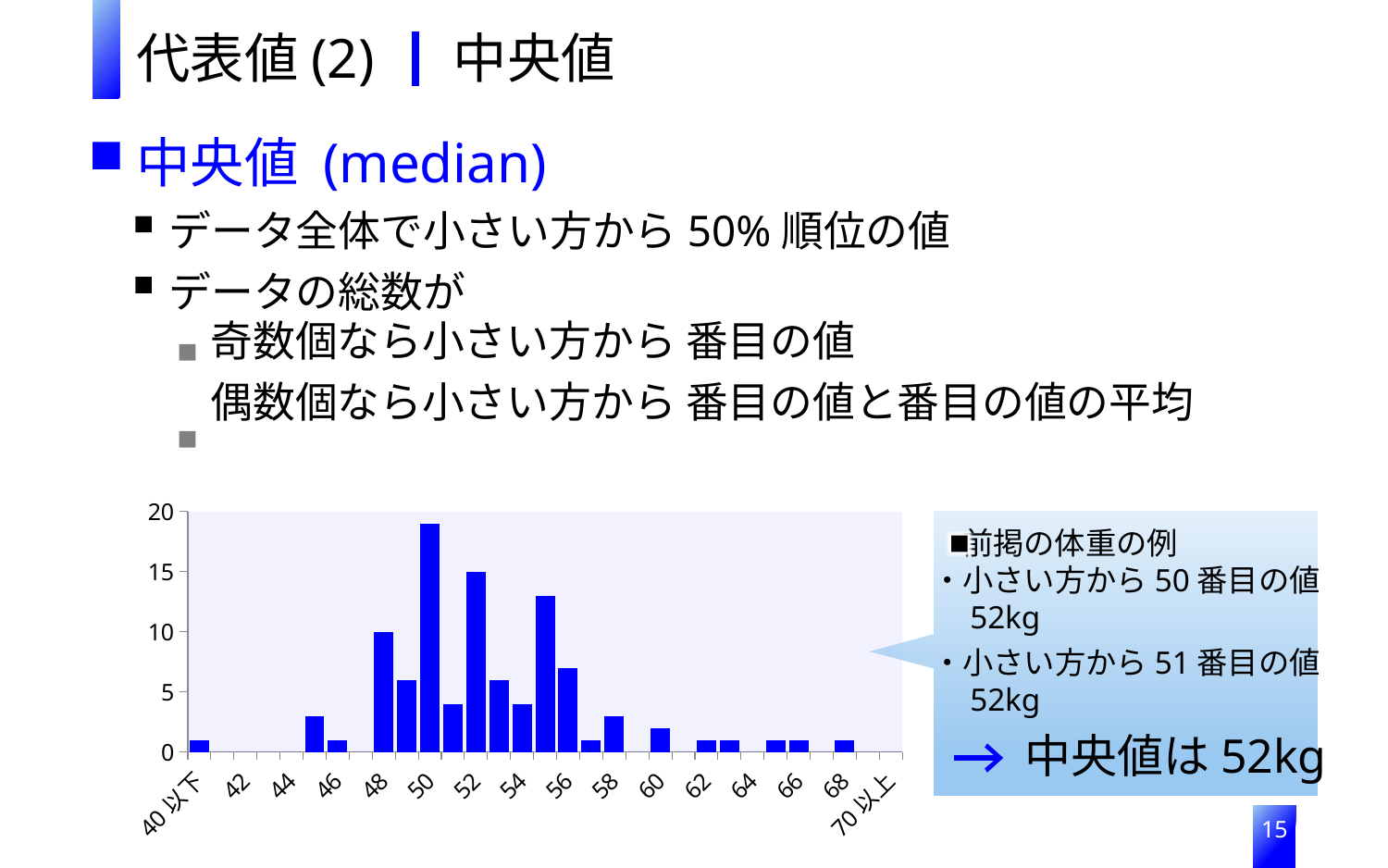
Which x-axis category has the tallest bar? 50 Which bar is taller, the one at 50 or the one at 52? 50 What is the highest tick value shown on the y-axis? 20 Is the value of the bar at 56 greater or less than 10? less Is the value of the bar at 50 greater or less than 15? greater Is the value of the bar at 58 greater or less than 5? less What kind of chart is shown on the slide? bar chart What is the label of the leftmost category on the x-axis? 40以下 Which bar is taller, the one at 48 or the one at 58? 48